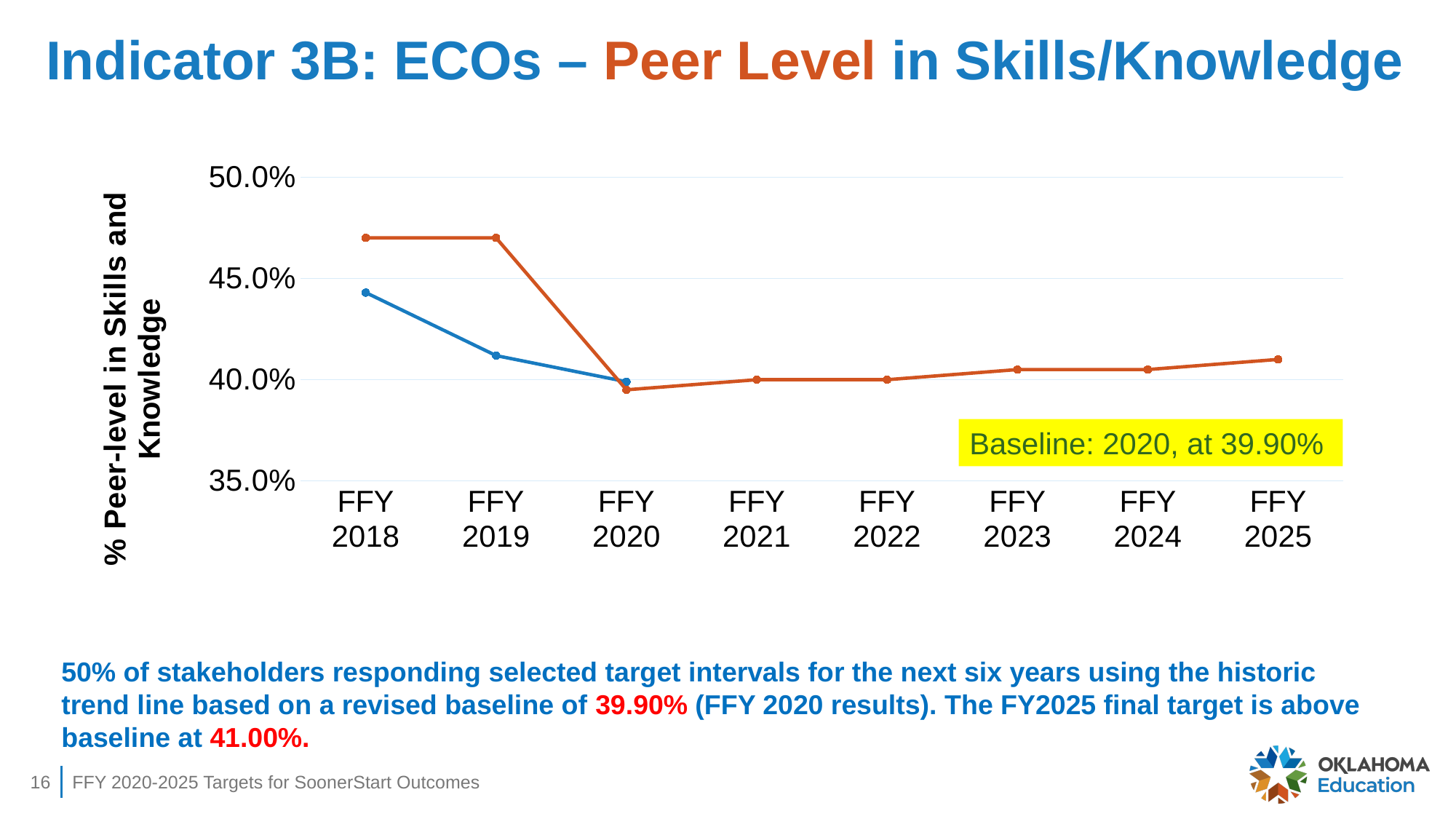
Does the blue line rise or fall from FFY 2018 to FFY 2020? fall How many FFY categories are shown on the x axis? 8 Is the value of the orange line at FFY 2019 greater or less than 45.0%? greater What is the label on the vertical axis of the chart? % Peer-level in Skills and Knowledge What is the difference between the FY2025 final target (41.00%) and the 2020 baseline (39.90%)? 1.10% According to the annotation on the chart, what is the baseline value for 2020? 39.90% What is the FY2025 final target value stated on the slide? 41.00% Is the value of the orange line at FFY 2018 greater or less than 45.0%? greater What kind of chart is shown on the slide? line chart At which FFY does the blue line reach its lowest value? FFY 2020 Is the value of the blue line at FFY 2019 greater or less than 40.0%? greater At FFY 2018, which line has the higher value, the orange line or the blue line? orange line